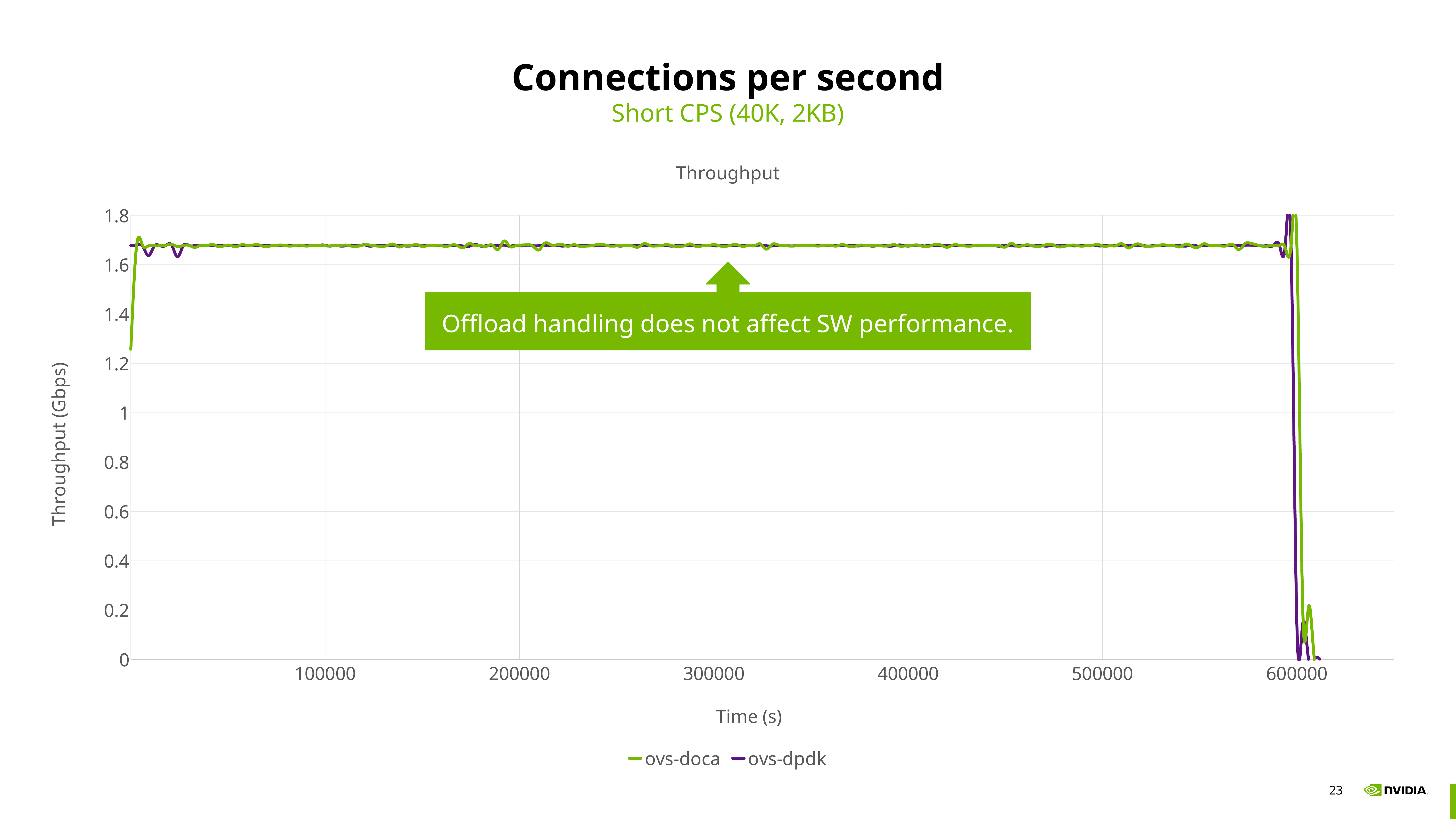
What are the names of the two series in the legend? ovs-doca and ovs-dpdk Is the value for ovs-dpdk at time 500000 greater or less than 1.4? greater Is the value for ovs-dpdk at time 300000 greater or less than 1.8? less Does the ovs-doca throughput stay roughly flat or change steadily between 100000 and 500000 seconds? roughly flat What happens to both series' throughput shortly after 600000 seconds? it drops to 0 Is the value for ovs-doca at time 100000 greater or less than 1? greater What kind of chart is shown on the slide? line chart How many series does the legend list? 2 What is the title of the chart? Throughput What is the label of the x axis? Time (s)